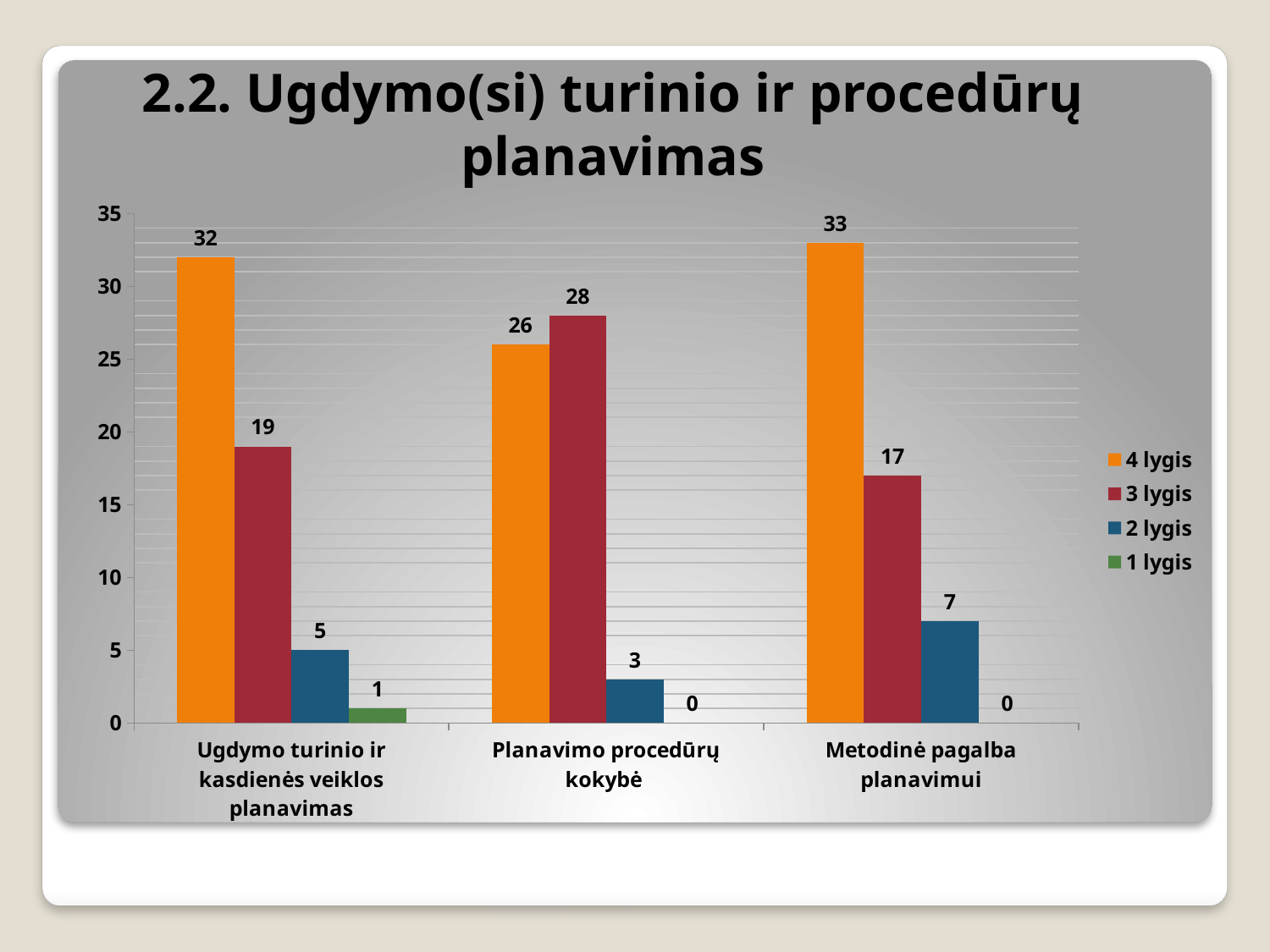
What kind of chart is shown on the slide? Bar chart What is the value of the 2 lygis series for Metodinė pagalba planavimui? 7 What is the value of the 4 lygis series for Ugdymo turinio ir kasdienės veiklos planavimas? 32 For Planavimo procedūrų kokybė, which is larger: the 4 lygis value or the 3 lygis value? 3 lygis How many categories are shown on the x axis? 3 What is the value of the 3 lygis series for Planavimo procedūrų kokybė? 28 What colour represents the 2 lygis series in the legend? Blue What is the value of the 1 lygis series for Planavimo procedūrų kokybė? 0 What is the difference between the 4 lygis and 3 lygis values for Metodinė pagalba planavimui? 16 Which category has the highest value for the 4 lygis series? Metodinė pagalba planavimui Which category has the lowest value for the 3 lygis series? Metodinė pagalba planavimui How many series does the legend list? 4